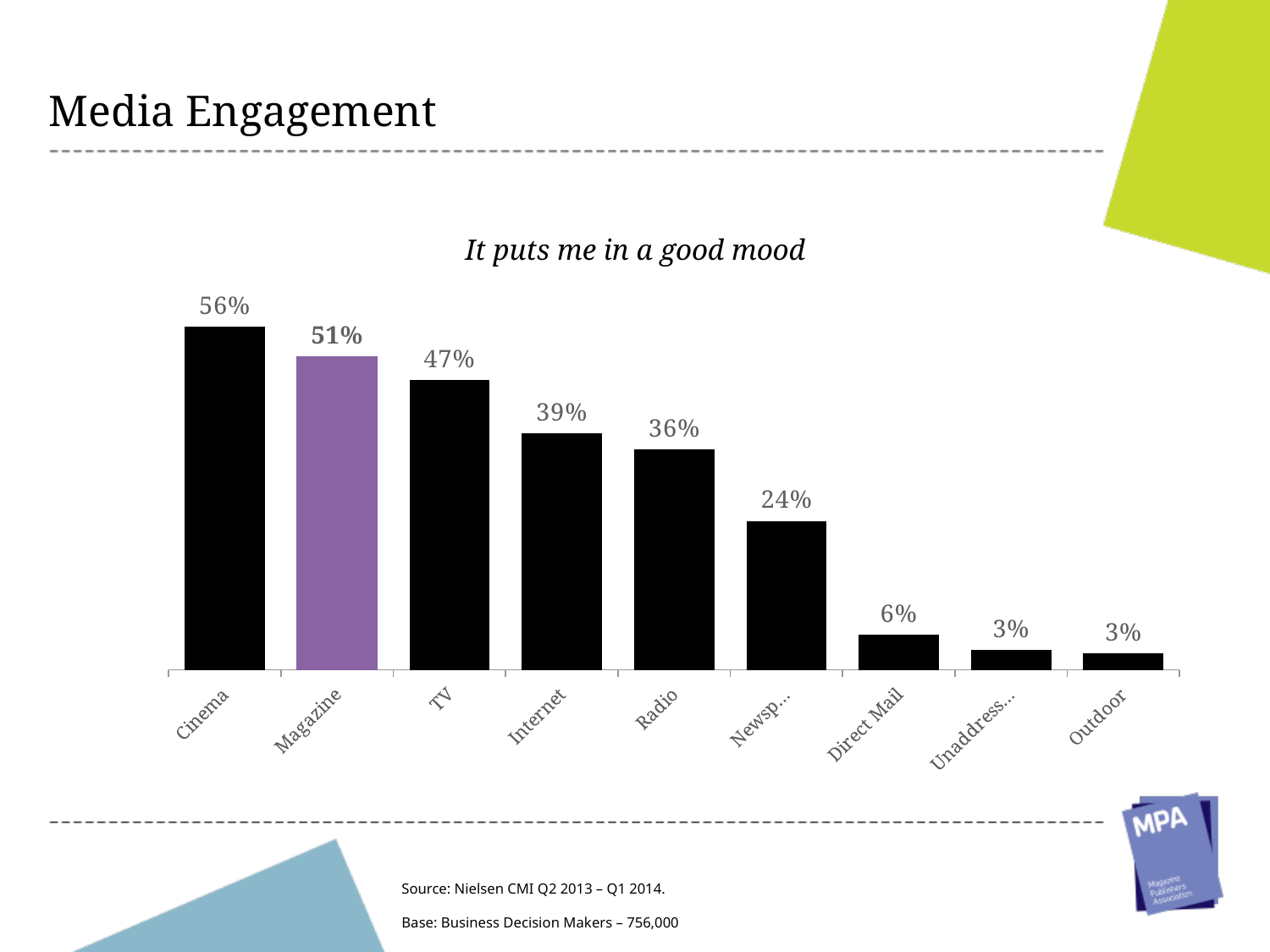
Do the values rise or fall from left to right along the x axis? Fall What is the difference between the values for Radio and Direct Mail? 30% What is the difference between the values for Cinema and Magazine? 5% What is the value for Cinema in the chart? 56% Which is larger, the value for Internet or the value for Radio? Internet What is the value for TV in the chart? 47% Which category has the highest value in the chart? Cinema What is the value for Magazine in the chart? 51% What is the value for Direct Mail in the chart? 6% What kind of chart is shown on the slide? Bar chart What is the value for Internet in the chart? 39% How many categories are shown in the chart? 9